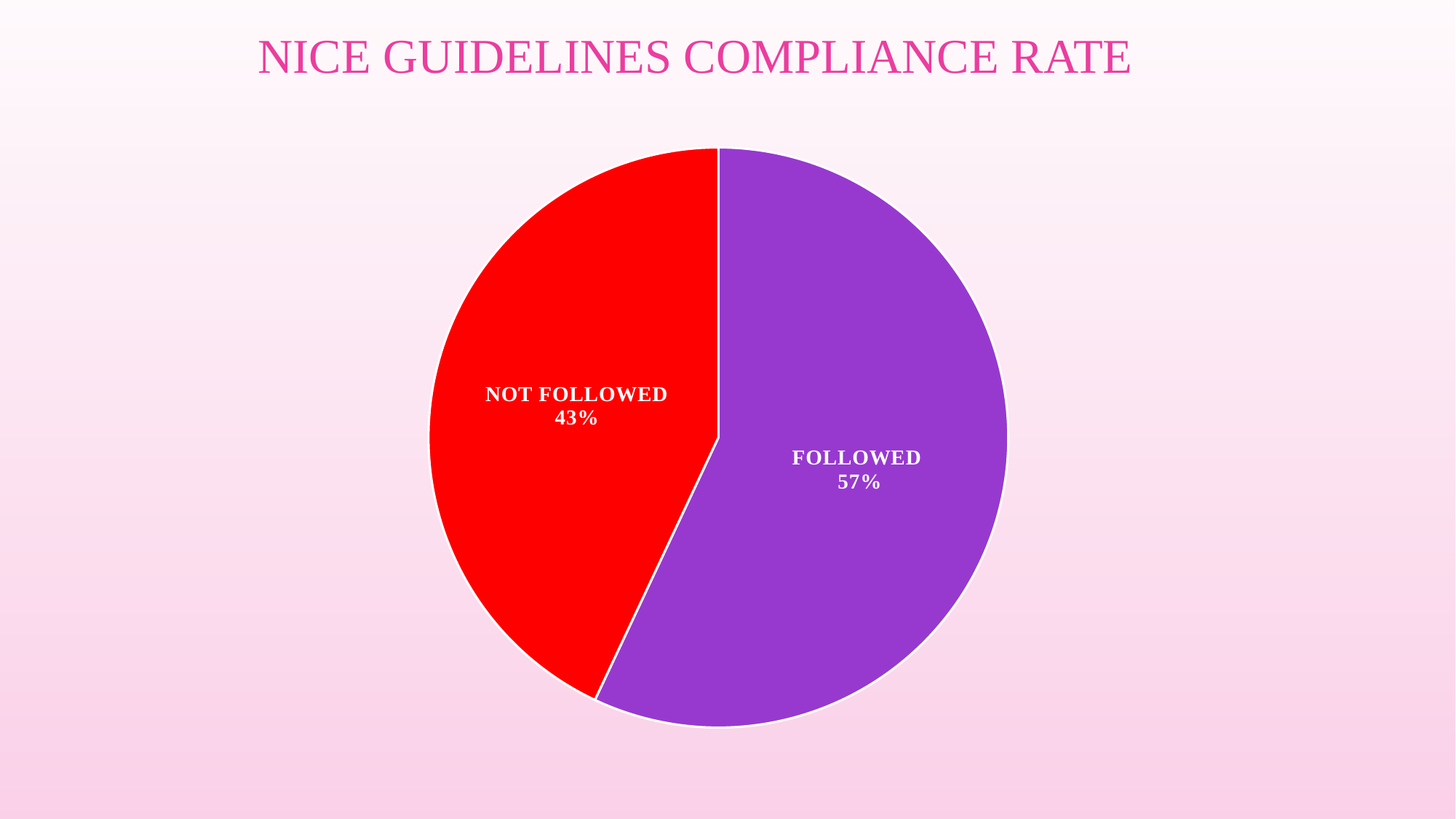
Which slice is the largest? FOLLOWED What colour is the FOLLOWED slice? purple What is the title of the chart? NICE GUIDELINES COMPLIANCE RATE How many slices does the pie chart have? 2 Which is larger, the FOLLOWED slice or the NOT FOLLOWED slice? FOLLOWED What kind of chart is shown on the slide? pie chart Which slice is the smallest? NOT FOLLOWED What share of the pie is labelled NOT FOLLOWED? 43% What share of the pie is labelled FOLLOWED? 57% Is the FOLLOWED share greater or less than 50%? greater What is the difference between the FOLLOWED and NOT FOLLOWED shares? 14%